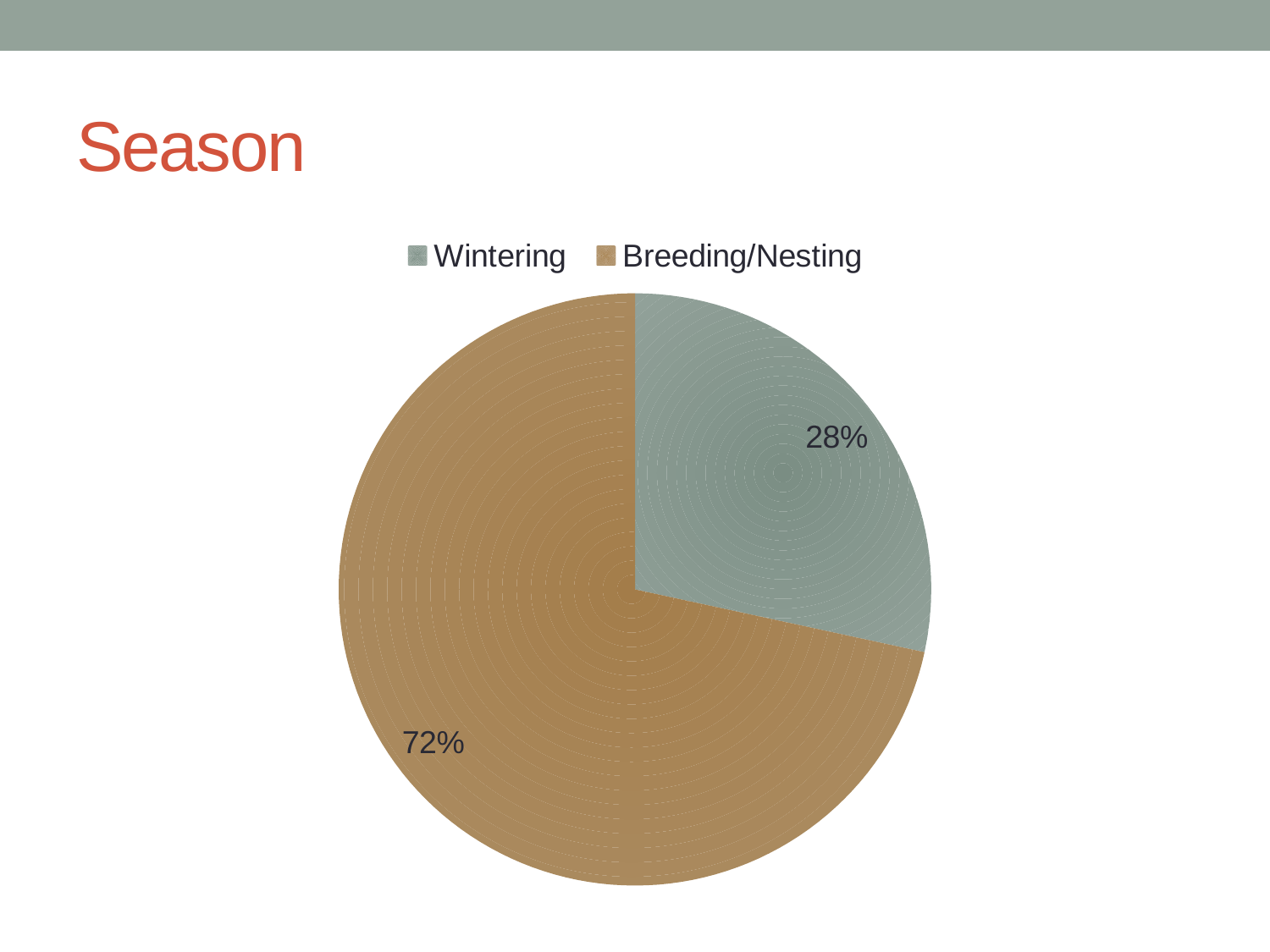
How many entries does the legend list? 2 How many categories does the pie chart show? 2 Is the share for Wintering greater or less than 50%? less Which category has the largest slice of the pie? Breeding/Nesting What kind of chart is shown on the slide? pie chart Which category has the smallest slice of the pie? Wintering What colour is the Breeding/Nesting slice? brown What share of the pie does Breeding/Nesting represent? 72% What share of the pie does Wintering represent? 28% What is the title of the slide containing the pie chart? Season What is the difference in percentage points between Breeding/Nesting and Wintering? 44 Which is larger, the Wintering slice or the Breeding/Nesting slice? Breeding/Nesting